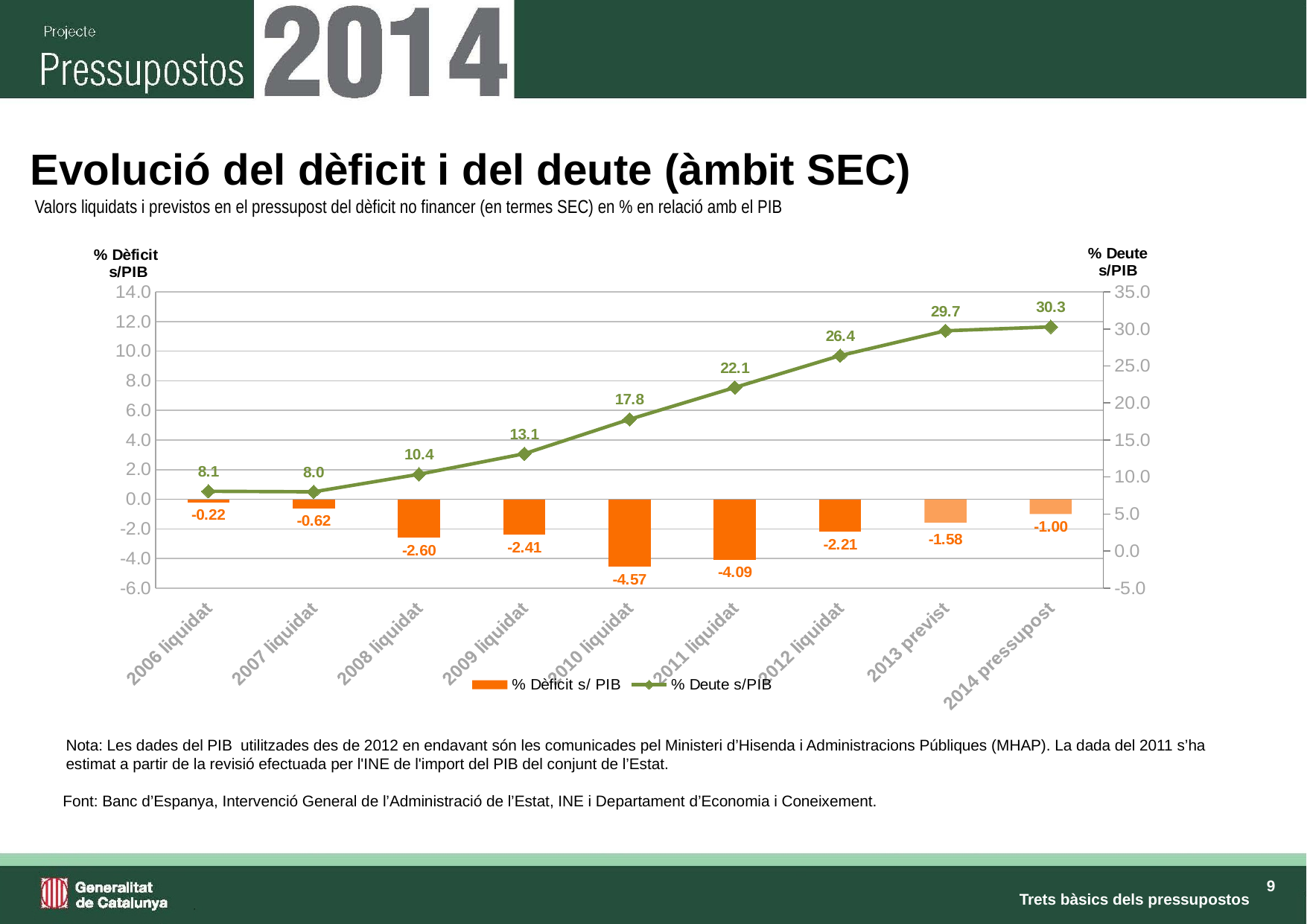
Does the % Deute s/PIB series generally rise or fall from 2007 liquidat to 2014 pressupost? Rise What kind of chart is shown on the slide? Combined bar and line chart What is the label of the right-hand vertical axis? % Deute s/PIB Which category has the highest % Deute s/PIB value? 2014 pressupost What is the % Dèficit s/PIB value for 2013 previst? -1.58 What is the difference between the % Deute s/PIB values for 2012 liquidat and 2011 liquidat? 4.3 How many series does the legend list? 2 Which category has the lowest (most negative) % Dèficit s/PIB value? 2010 liquidat What is the % Dèficit s/PIB value for 2010 liquidat? -4.57 Which is larger in absolute terms, the % Dèficit s/PIB for 2008 liquidat or for 2009 liquidat? 2008 liquidat What is the % Deute s/PIB value for 2014 pressupost? 30.3 How many categories are shown on the x axis? 9